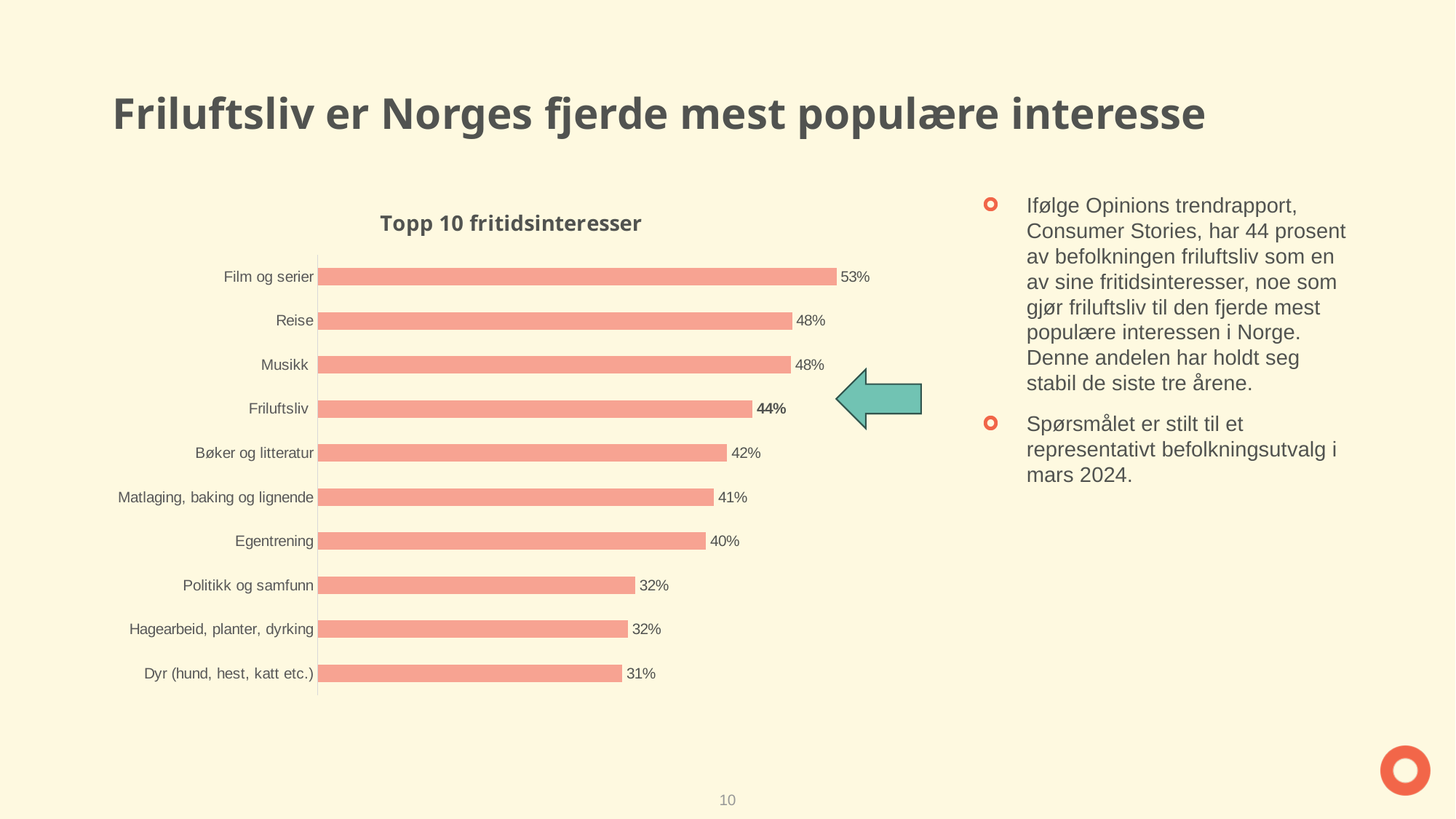
How many categories are shown in the chart? 10 What is the difference between the values for Film og serier and Friluftsliv? 9% What is the value for Film og serier? 53% Which is larger, the value for Reise or the value for Politikk og samfunn? Reise Which category has the lowest value? Dyr (hund, hest, katt etc.) What is the value for Matlaging, baking og lignende? 41% What is the value for Friluftsliv? 44% Which category does the arrow on the slide point to? Friluftsliv What is the title of the chart? Topp 10 fritidsinteresser Which category has the highest value? Film og serier What kind of chart is shown on the slide? Bar chart What is the difference between the values for Bøker og litteratur and Egentrening? 2%